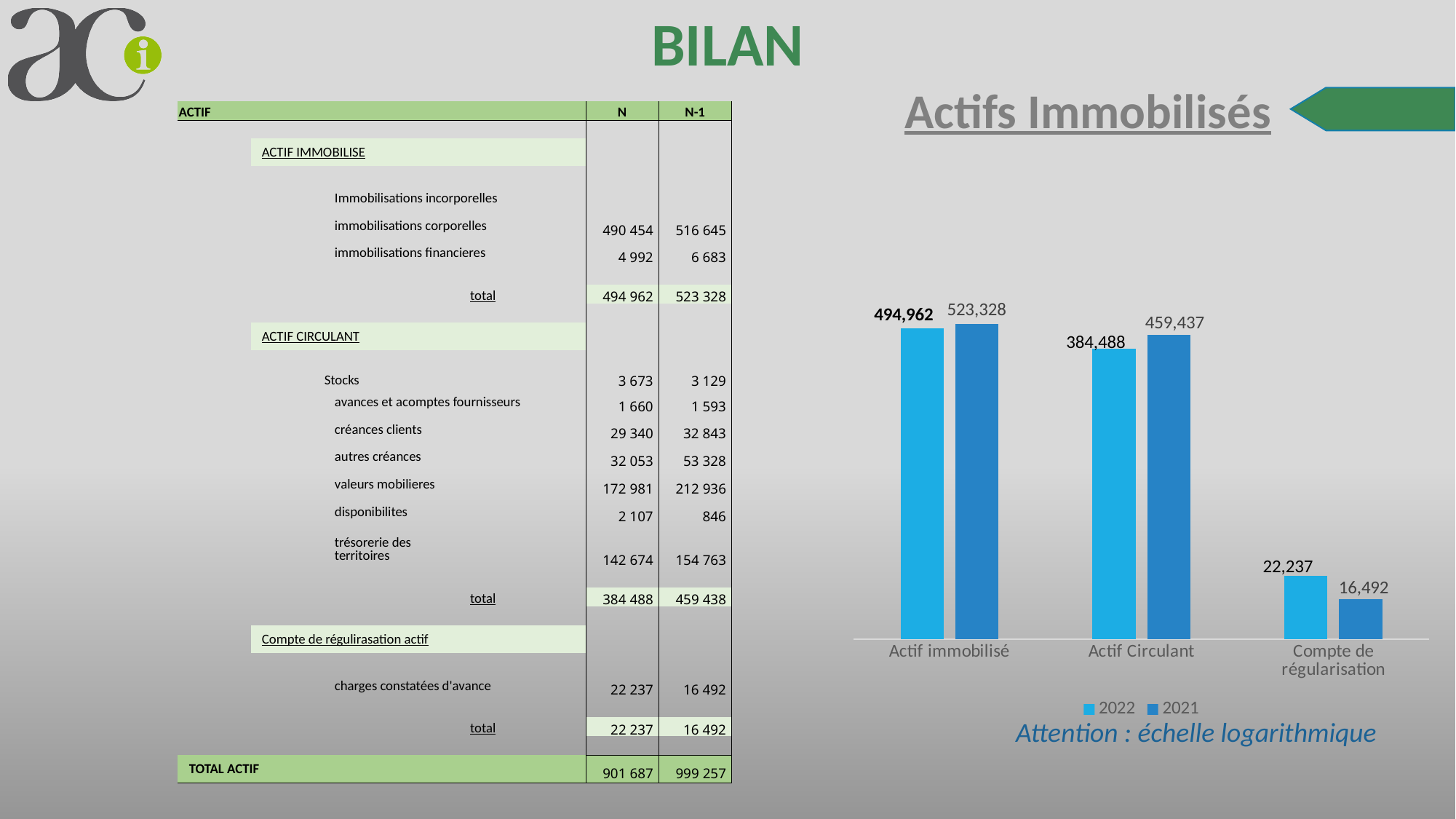
Which category has the highest value in the 2021 series? Actif immobilisé What is the value for Compte de régularisation in the 2021 series? 16,492 For Actif immobilisé, which series has the larger value, 2022 or 2021? 2021 How many series does the chart legend list? 2 What is the difference between the 2021 and 2022 values for Actif Circulant? 74,949 What is the value for Actif immobilisé in the 2022 series? 494,962 What is the value for Compte de régularisation in the 2022 series? 22,237 What is the difference between the 2022 and 2021 values for Compte de régularisation? 5,745 How many categories are shown on the x axis of the chart? 3 Which category has the lowest value in the 2022 series? Compte de régularisation What is the value for Actif Circulant in the 2021 series? 459,437 What kind of chart is shown on the slide? Bar chart